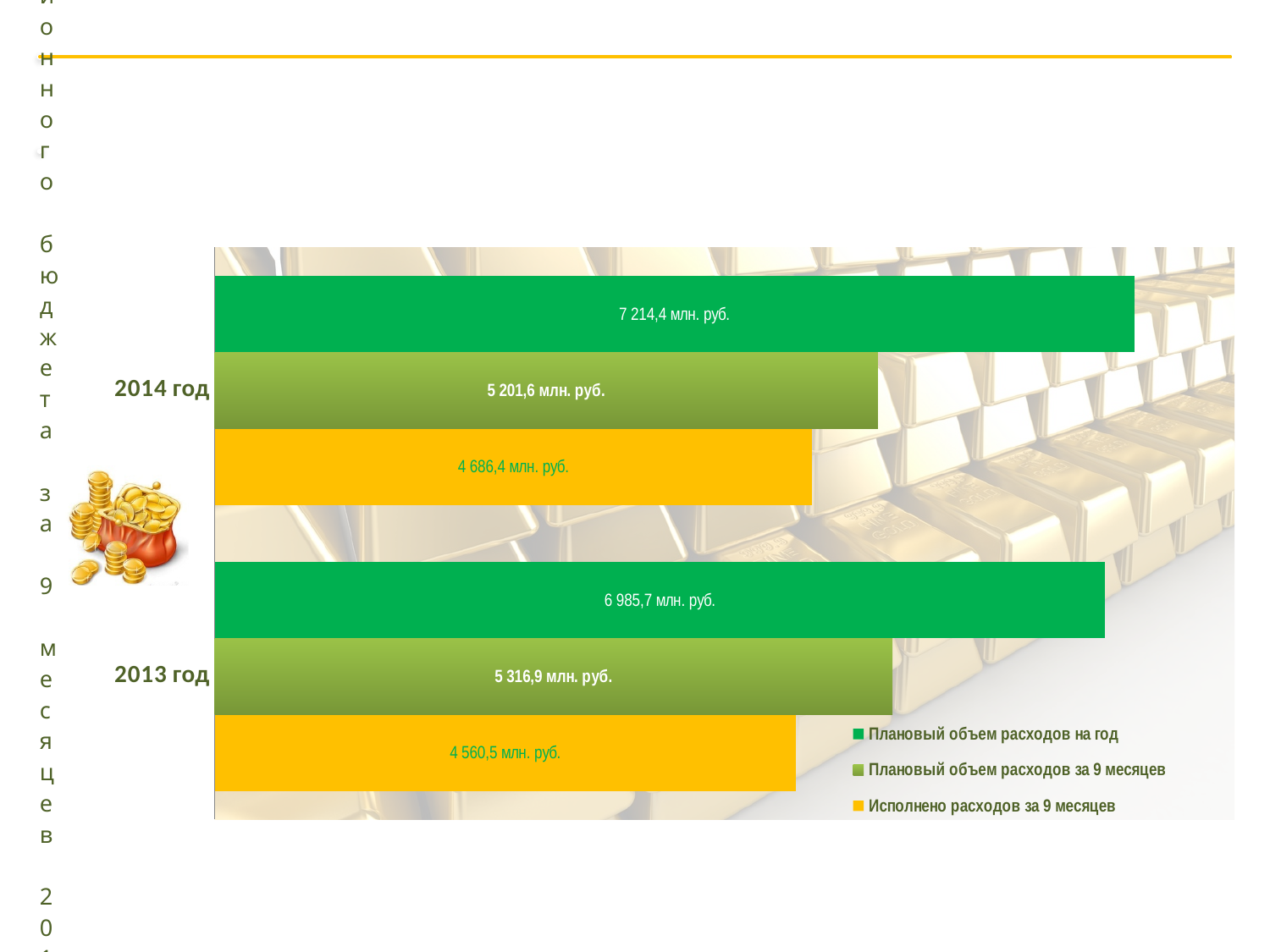
What is the value of "Исполнено расходов за 9 месяцев" for 2014 год? 4 686,4 млн. руб. What type of chart is shown on the slide? bar chart What is the value of "Плановый объем расходов на год" for 2014 год? 7 214,4 млн. руб. Which year has the higher value for "Плановый объем расходов за 9 месяцев"? 2013 год How many year categories are shown in the chart? 2 What is the difference between "Плановый объем расходов за 9 месяцев" and "Исполнено расходов за 9 месяцев" for 2014 год? 515,2 млн. руб. Which year has the higher value for "Плановый объем расходов на год"? 2014 год What is the value of "Плановый объем расходов за 9 месяцев" for 2013 год? 5 316,9 млн. руб. What is the difference between "Плановый объем расходов на год" for 2014 год and for 2013 год? 228,7 млн. руб. How many series does the legend list? 3 Which series is shown in yellow in the legend? Исполнено расходов за 9 месяцев What is the value of "Исполнено расходов за 9 месяцев" for 2013 год? 4 560,5 млн. руб.